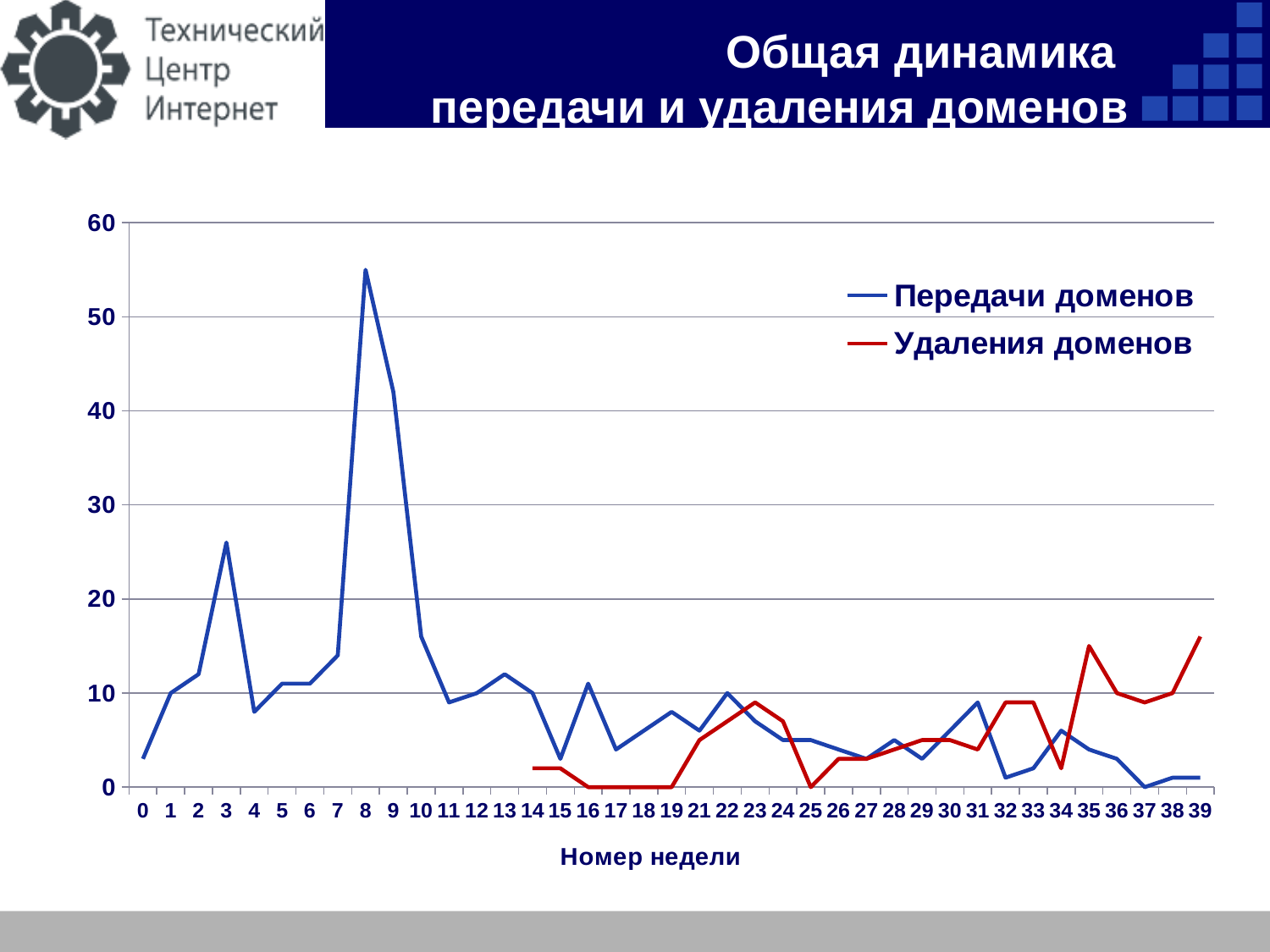
At which week number does the Передачи доменов series reach its highest value? 8 How many series does the legend list? 2 At week 39, which series has the larger value, Передачи доменов or Удаления доменов? Удаления доменов Is the value for Передачи доменов at week 8 greater or less than 50? greater Is the value for Передачи доменов at week 10 greater or less than 20? less What is the title of the x axis? Номер недели Is the value for Передачи доменов at week 0 greater or less than 10? less At week 32, which series has the larger value, Передачи доменов or Удаления доменов? Удаления доменов What kind of chart is shown on the slide? line chart Does the Передачи доменов series rise or fall from week 8 to week 11? fall